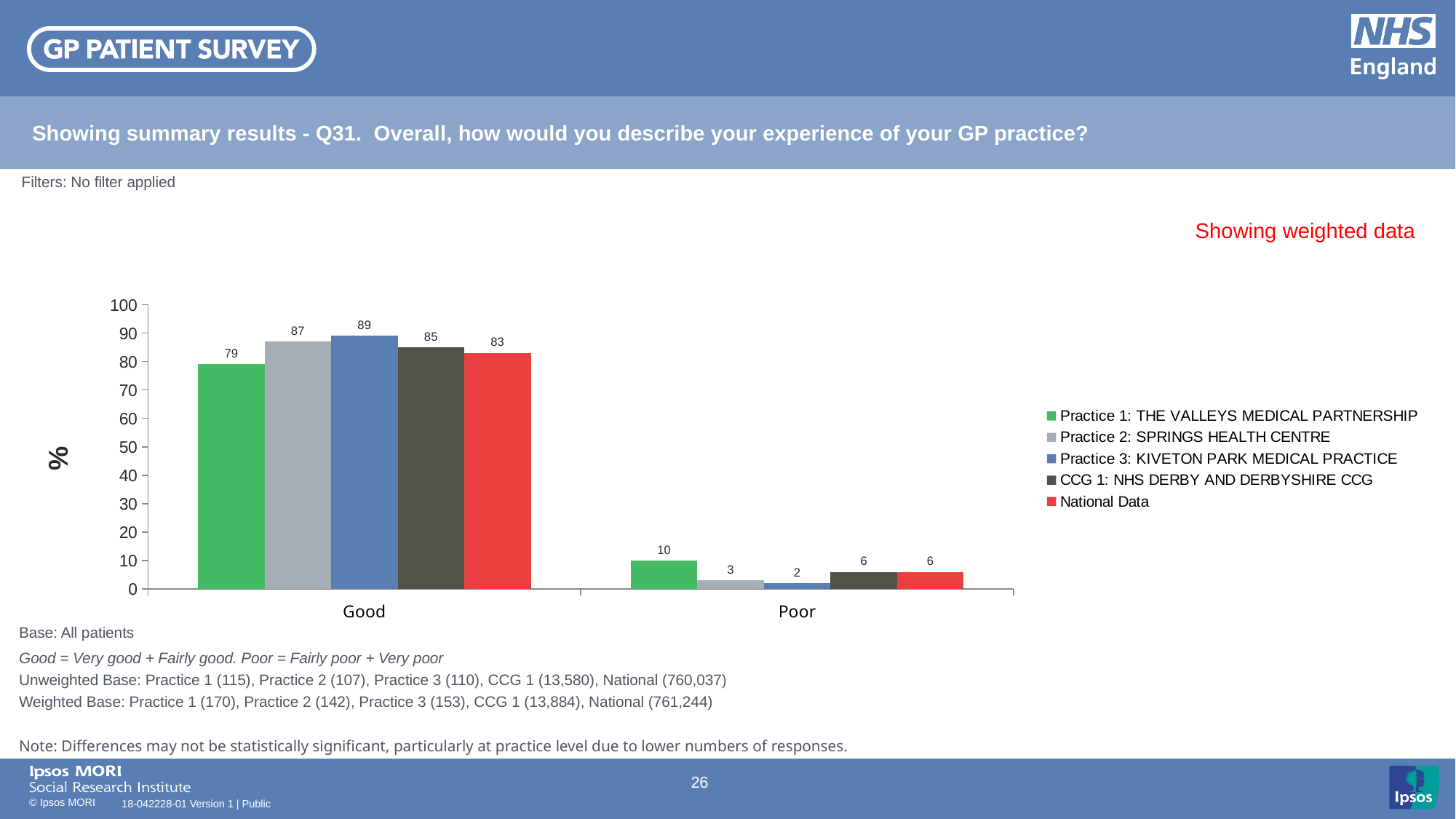
What is the value for Practice 3: KIVETON PARK MEDICAL PRACTICE in the Poor category? 2 How many categories are shown on the x axis? 2 What is the National Data value for the Good category? 83 Which series has the highest value in the Good category? Practice 3: KIVETON PARK MEDICAL PRACTICE How many series does the legend list? 5 What is the value for Practice 1: THE VALLEYS MEDICAL PARTNERSHIP in the Good category? 79 Which series has the lowest value in the Poor category? Practice 3: KIVETON PARK MEDICAL PRACTICE Is the Good value for CCG 1: NHS DERBY AND DERBYSHIRE CCG greater or less than 80? greater What kind of chart is shown on the slide? Bar chart What is the difference between the Good values for Practice 2: SPRINGS HEALTH CENTRE and Practice 1: THE VALLEYS MEDICAL PARTNERSHIP? 8 In the Poor category, which is larger: the value for Practice 1: THE VALLEYS MEDICAL PARTNERSHIP or the value for CCG 1: NHS DERBY AND DERBYSHIRE CCG? Practice 1: THE VALLEYS MEDICAL PARTNERSHIP What is the label on the y axis of the chart? %